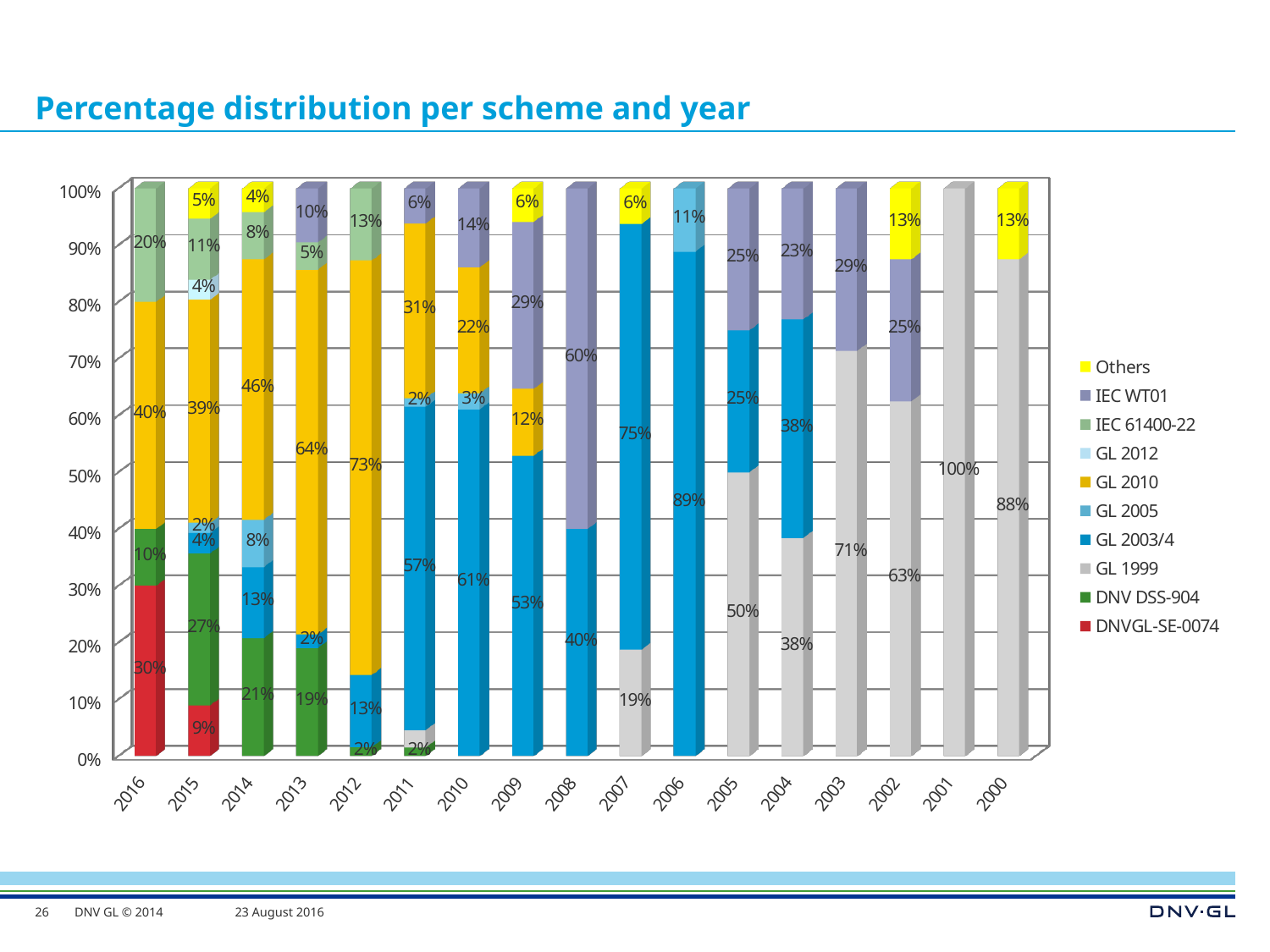
What is the value for GL 2010 in 2012? 73% What kind of chart is shown on the slide? Stacked bar chart How many series does the legend list? 10 How many years are shown on the x axis? 17 What is the difference between the GL 2003/4 value in 2007 and the GL 1999 value in 2007? 56% What is the value for GL 1999 in 2001? 100% In which year is the GL 2010 share the highest? 2012 What is the title of the chart? Percentage distribution per scheme and year Which is larger in 2005: the GL 1999 share or the GL 2003/4 share? GL 1999 What is the value for DNVGL-SE-0074 in 2016? 30% What is the value for GL 2003/4 in 2006? 89% What is the value for IEC WT01 in 2008? 60%